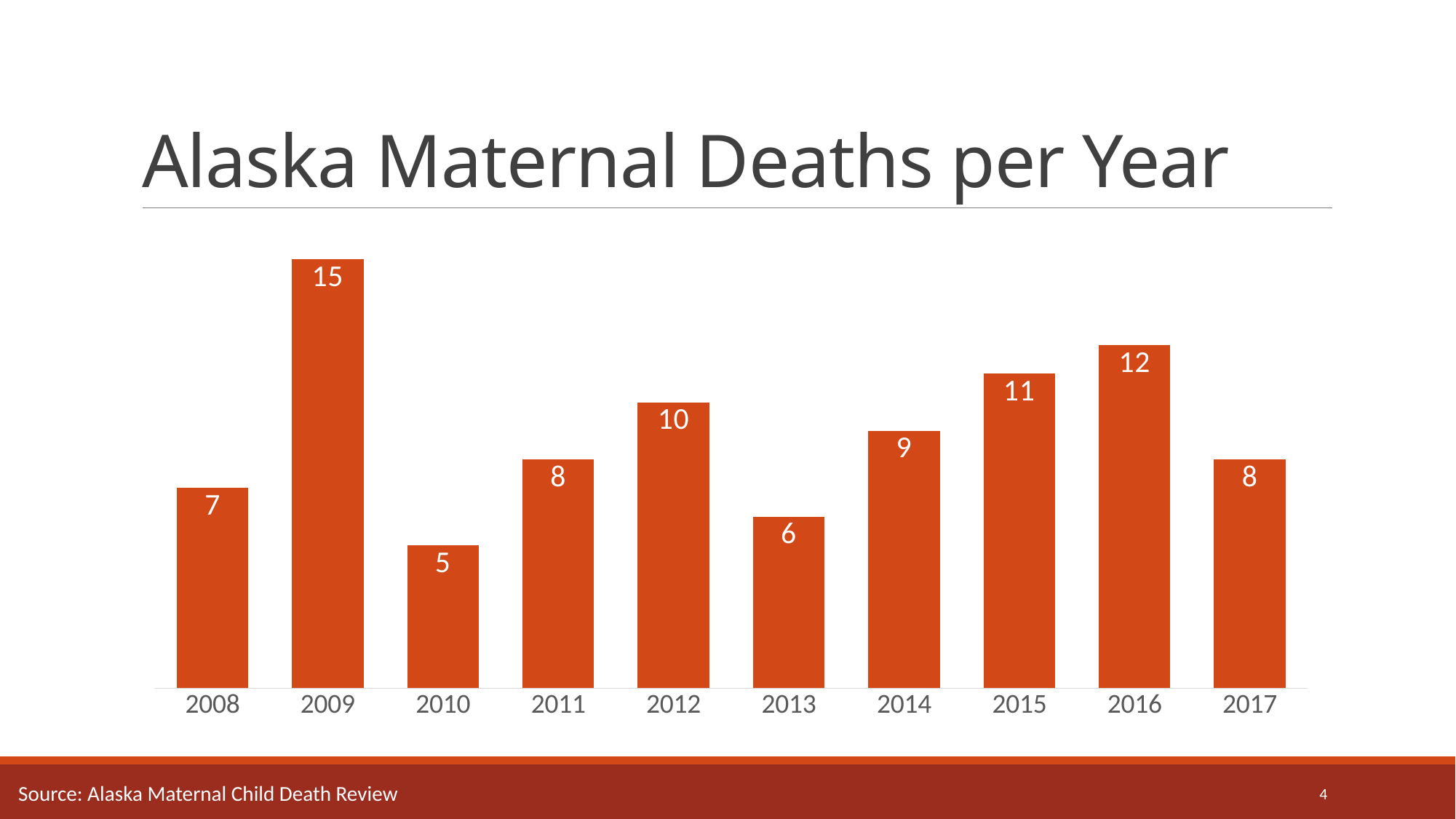
What is the difference between the values for 2009 and 2010? 10 How many years are shown on the x axis? 10 What is the value shown for 2016? 12 Which year has the lowest number of maternal deaths? 2010 Which year has the highest number of maternal deaths? 2009 What is the title of the chart? Alaska Maternal Deaths per Year Do the values rise or fall from 2013 to 2016? Rise Which year has a larger value, 2012 or 2014? 2012 What is the value shown for 2013? 6 What kind of chart is shown on the slide? Bar chart How many maternal deaths were recorded in Alaska in 2009? 15 What is the difference between the values for 2016 and 2017? 4